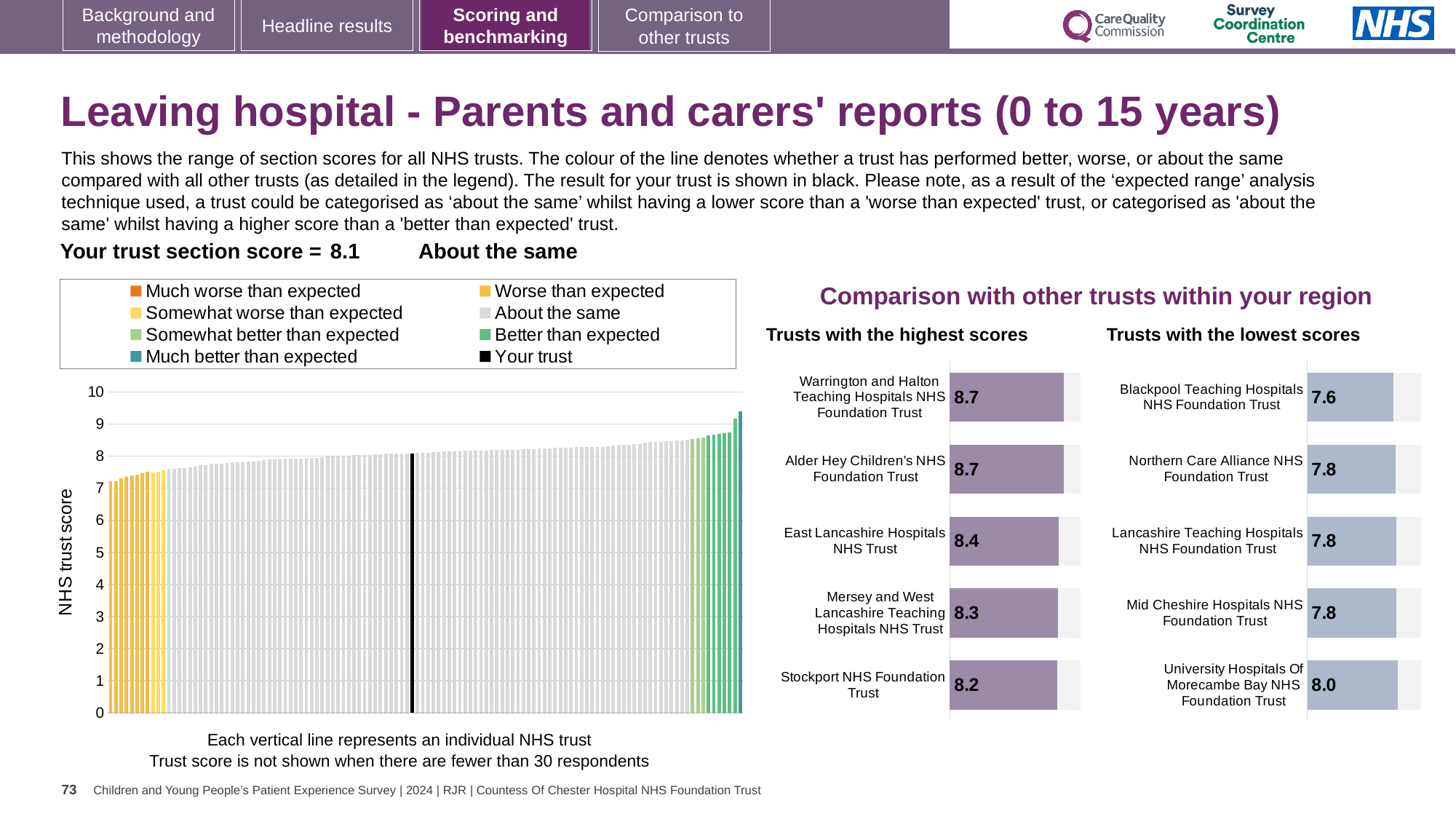
In the 'Trusts with the lowest scores' chart, what is the difference between the scores of University Hospitals Of Morecambe Bay NHS Foundation Trust and Blackpool Teaching Hospitals NHS Foundation Trust? 0.4 How many trusts are shown in the 'Trusts with the highest scores' chart? 5 In the 'Trusts with the lowest scores' chart, which trust has the lowest score? Blackpool Teaching Hospitals NHS Foundation Trust In the 'Trusts with the lowest scores' chart, what is the score for Blackpool Teaching Hospitals NHS Foundation Trust? 7.6 What is the label on the vertical axis of the main chart on the left? NHS trust score In the 'Trusts with the highest scores' chart, what is the difference between the scores of East Lancashire Hospitals NHS Trust and Stockport NHS Foundation Trust? 0.2 Which has the higher score: Mersey and West Lancashire Teaching Hospitals NHS Trust in the highest scores chart or Mid Cheshire Hospitals NHS Foundation Trust in the lowest scores chart? Mersey and West Lancashire Teaching Hospitals NHS Trust What kind of chart is the main chart on the left showing NHS trust scores? Bar chart In the 'Trusts with the highest scores' chart, what is the score for East Lancashire Hospitals NHS Trust? 8.4 In the main 'NHS trust score' chart, do the values rise or fall from left to right? Rise How many entries does the legend of the main 'NHS trust score' chart list? 8 In the 'Trusts with the highest scores' chart, which trust has the lowest score? Stockport NHS Foundation Trust